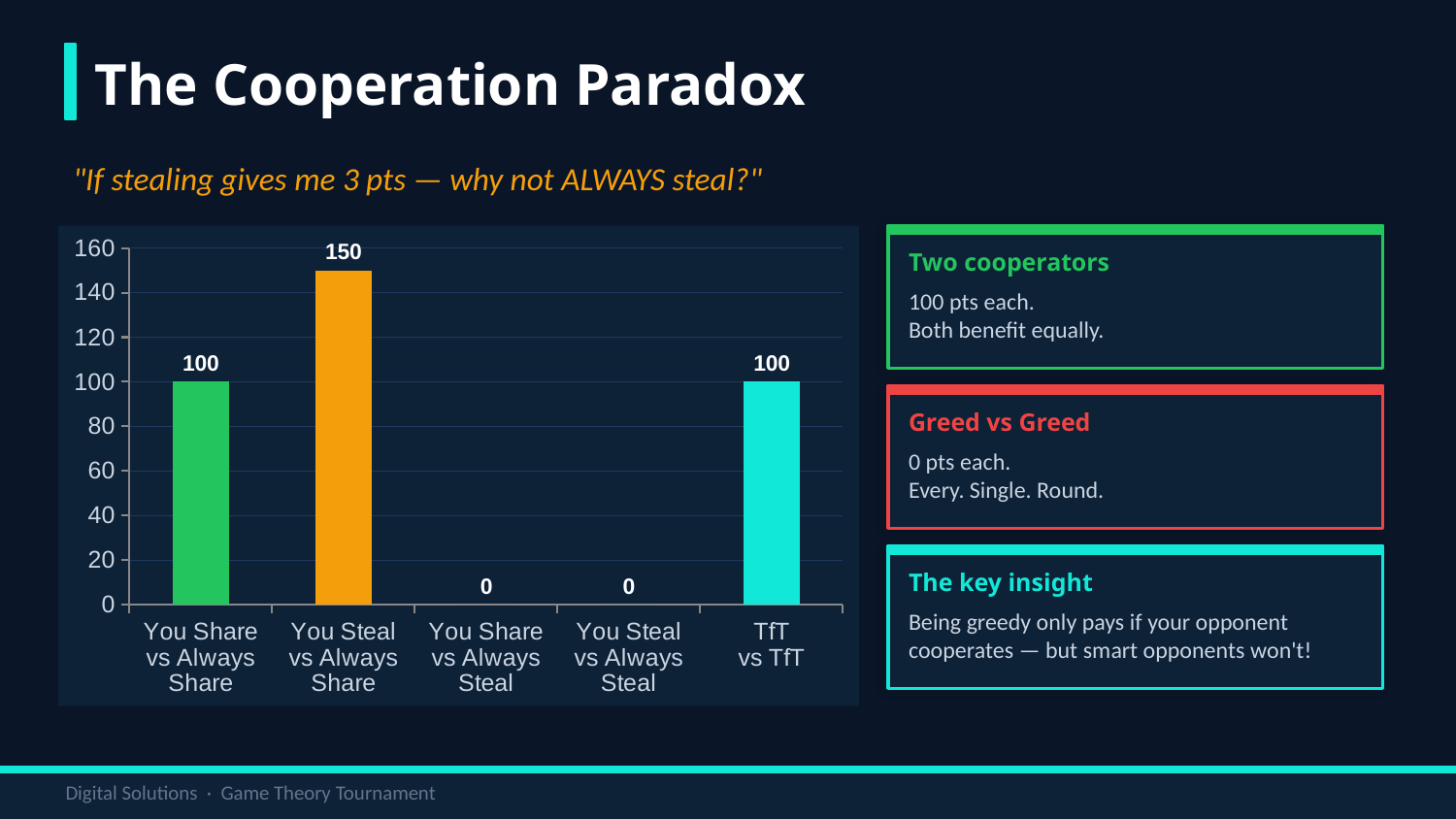
Which category has the highest value? You Steal vs Always Share How many categories have a value of 0? 2 How many categories are shown on the x axis? 5 What is the difference between 'You Steal vs Always Share' and 'You Share vs Always Share'? 50 What is the value for 'TfT vs TfT'? 100 Is the value for 'You Steal vs Always Share' greater or less than 140? greater What colour is the bar for 'You Steal vs Always Share'? orange What is the value for 'You Share vs Always Steal'? 0 What is the value for 'You Share vs Always Share'? 100 Which is larger, 'You Steal vs Always Share' or 'TfT vs TfT'? You Steal vs Always Share What is the value for 'You Steal vs Always Share'? 150 What kind of chart is shown on the slide? bar chart